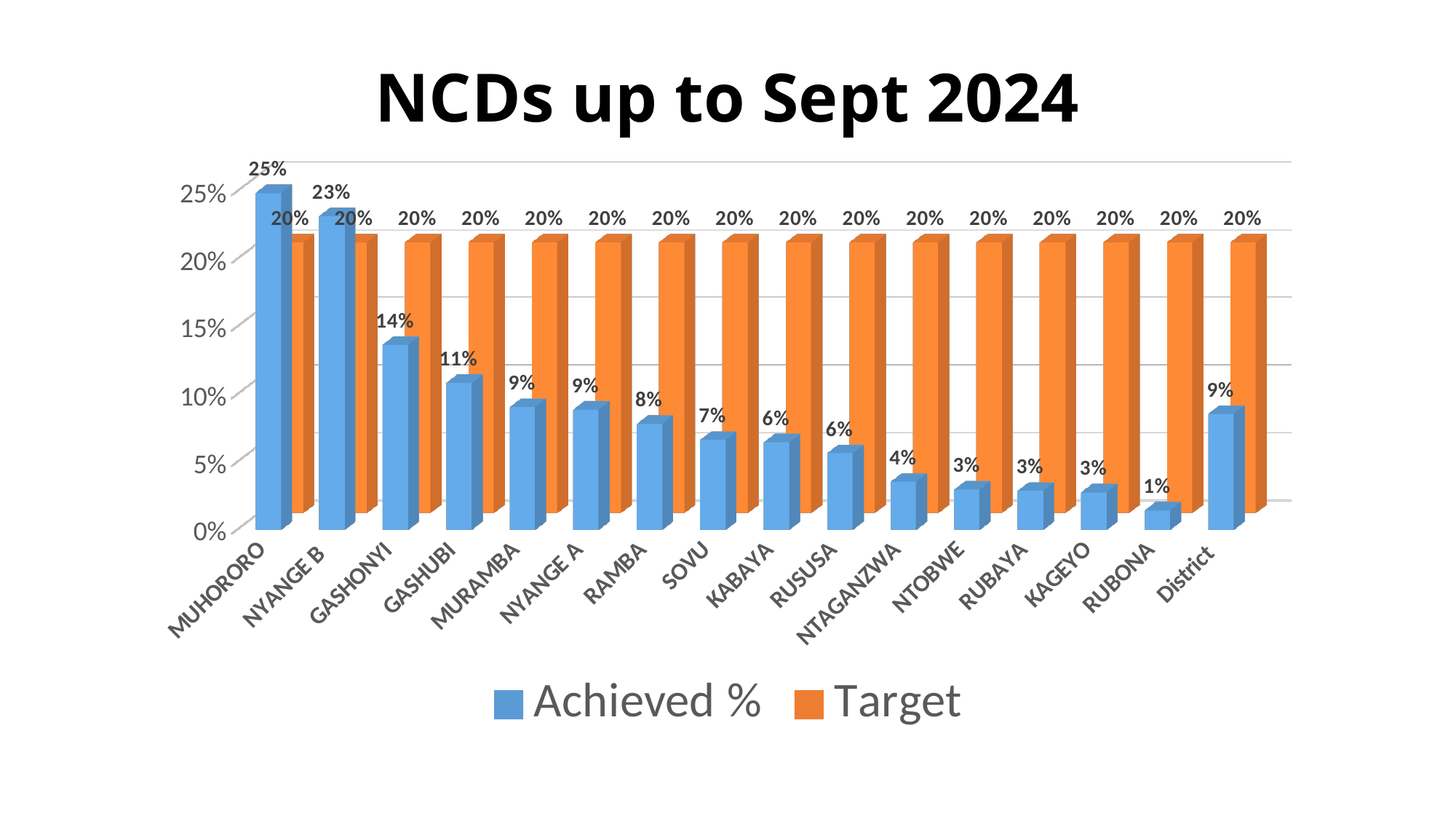
How many categories are shown on the x axis? 16 How many series does the legend list? 2 What is the difference between the Achieved % values for MUHORORO and NYANGE B? 2% What is the difference between the Target and Achieved % values for GASHUBI? 9% Which category has the highest Achieved % value? MUHORORO What is the Achieved % value for District? 9% Which is larger, the Achieved % value for MURAMBA or the Achieved % value for RAMBA? MURAMBA What is the Target value for SOVU? 20% What is the Achieved % value for GASHONYI? 14% What kind of chart is shown on the slide? Bar chart What is the Achieved % value for RUBONA? 1% Which category has the lowest Achieved % value? RUBONA